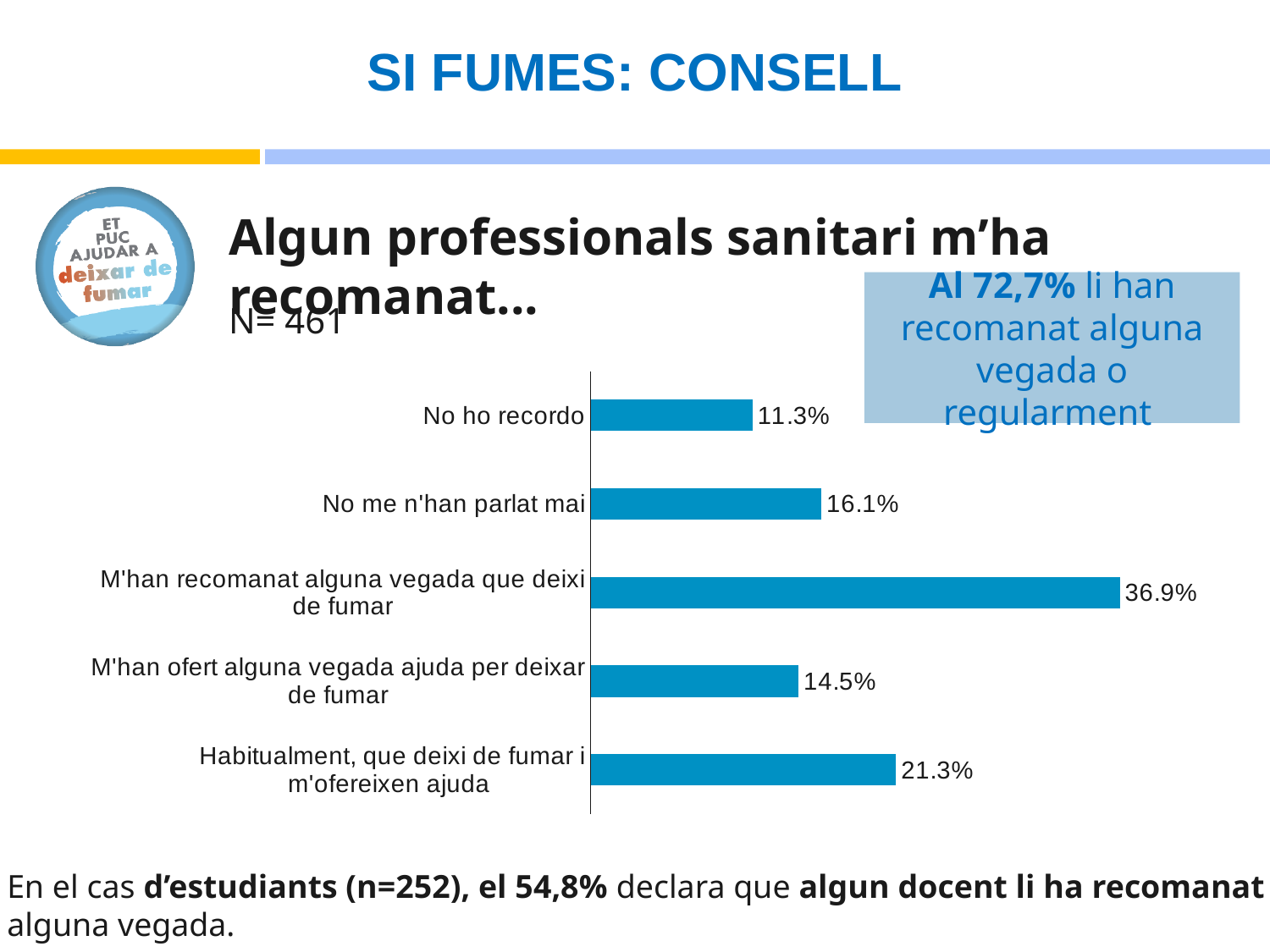
What kind of chart is shown on the slide? Bar chart What value is shown for 'No me n'han parlat mai'? 16.1% Which category has the highest value? M'han recomanat alguna vegada que deixi de fumar What is the sample size (N) stated for the chart? N= 461 What is the difference between the values for 'M'han recomanat alguna vegada que deixi de fumar' and 'Habitualment, que deixi de fumar i m'ofereixen ajuda'? 15.6% What value is shown for 'No ho recordo'? 11.3% What value is shown for 'M'han recomanat alguna vegada que deixi de fumar'? 36.9% What value is shown for 'M'han ofert alguna vegada ajuda per deixar de fumar'? 14.5% How many categories are shown in the chart? 5 Which category has the lowest value? No ho recordo Which is larger: the value for 'No me n'han parlat mai' or the value for 'M'han ofert alguna vegada ajuda per deixar de fumar'? No me n'han parlat mai What value is shown for 'Habitualment, que deixi de fumar i m'ofereixen ajuda'? 21.3%